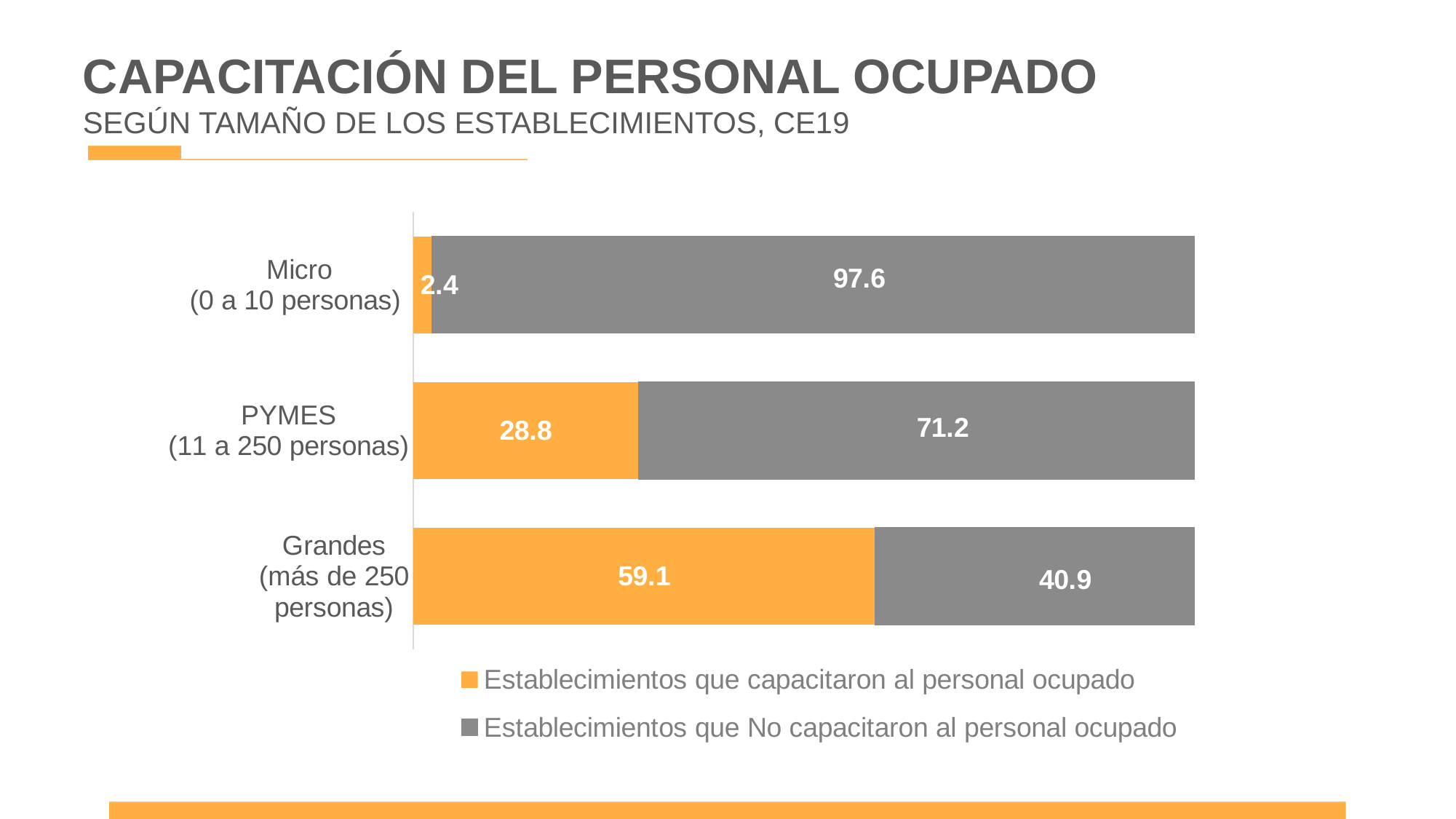
What kind of chart is shown on the slide? Stacked bar chart How many series does the legend list? 2 What is the value for 'Establecimientos que capacitaron al personal ocupado' for Grandes (más de 250 personas)? 59.1 Which category has the lowest value for 'Establecimientos que capacitaron al personal ocupado'? Micro (0 a 10 personas) Which is larger for Grandes (más de 250 personas): the value for establishments that trained staff or the value for those that did not? Establecimientos que capacitaron al personal ocupado What is the value for 'Establecimientos que capacitaron al personal ocupado' for Micro (0 a 10 personas)? 2.4 Which category has the highest value for 'Establecimientos que No capacitaron al personal ocupado'? Micro (0 a 10 personas) How many categories are shown on the chart? 3 What is the total of the stacked bar for PYMES (11 a 250 personas)? 100 What is the value for 'Establecimientos que No capacitaron al personal ocupado' for PYMES (11 a 250 personas)? 71.2 What colour represents 'Establecimientos que capacitaron al personal ocupado' in the chart? Orange What is the difference between the 'Establecimientos que capacitaron al personal ocupado' values for Grandes and PYMES? 30.3